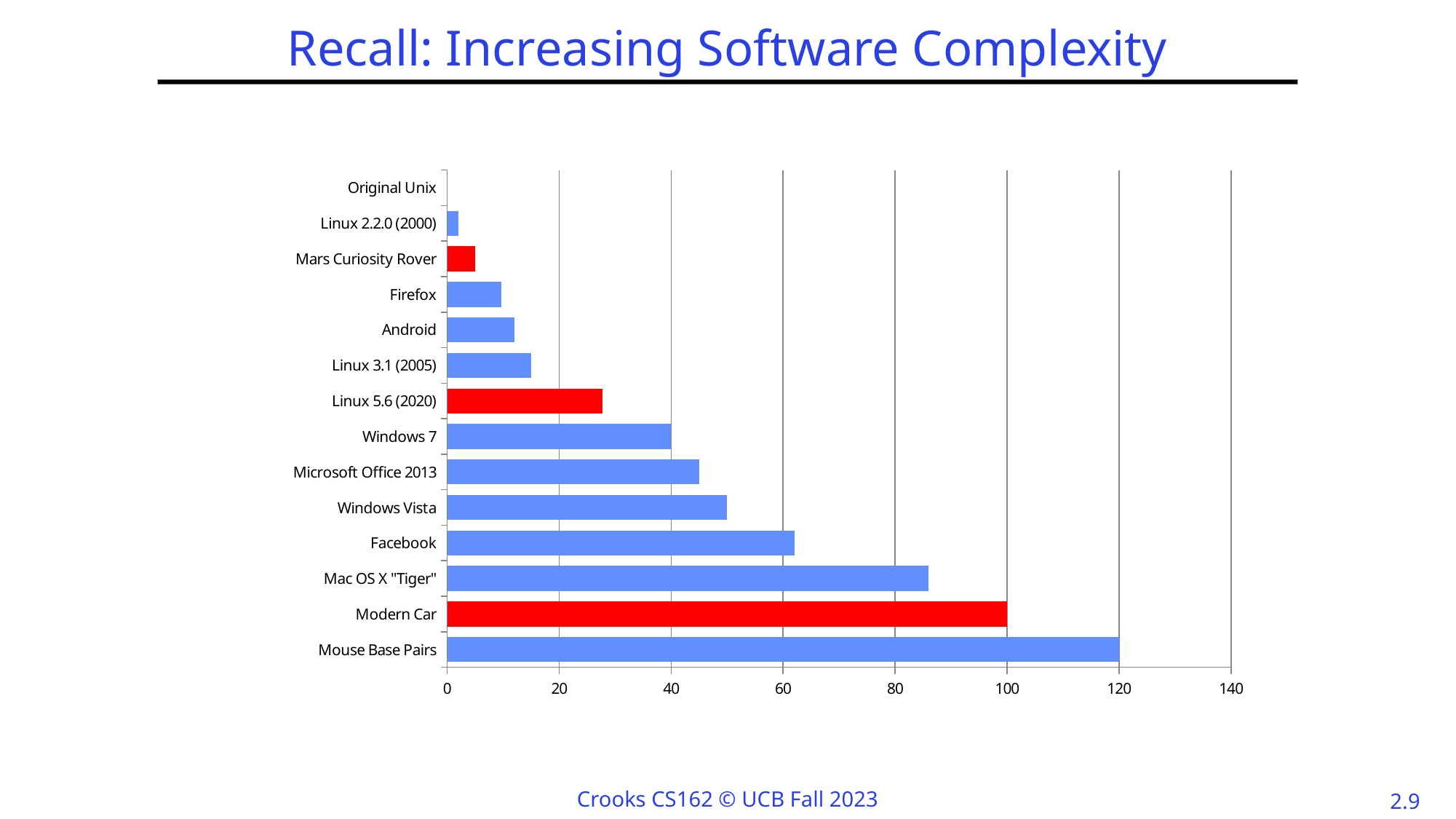
What is the value for Modern Car? 100 How many categories are plotted in the chart? 14 What is the value for Windows 7? 40 Is the value for Linux 5.6 (2020) greater or less than 40? less What kind of chart is shown on the slide? bar chart Which category has the longest bar in the chart? Mouse Base Pairs Is the value for Facebook greater or less than 60? greater What is the title of the slide containing the chart? Recall: Increasing Software Complexity Is the value for Mac OS X "Tiger" greater or less than 80? greater Which category has the shortest bar in the chart? Original Unix Which is larger, the value for Windows Vista or the value for Android? Windows Vista What is the value for Mouse Base Pairs? 120